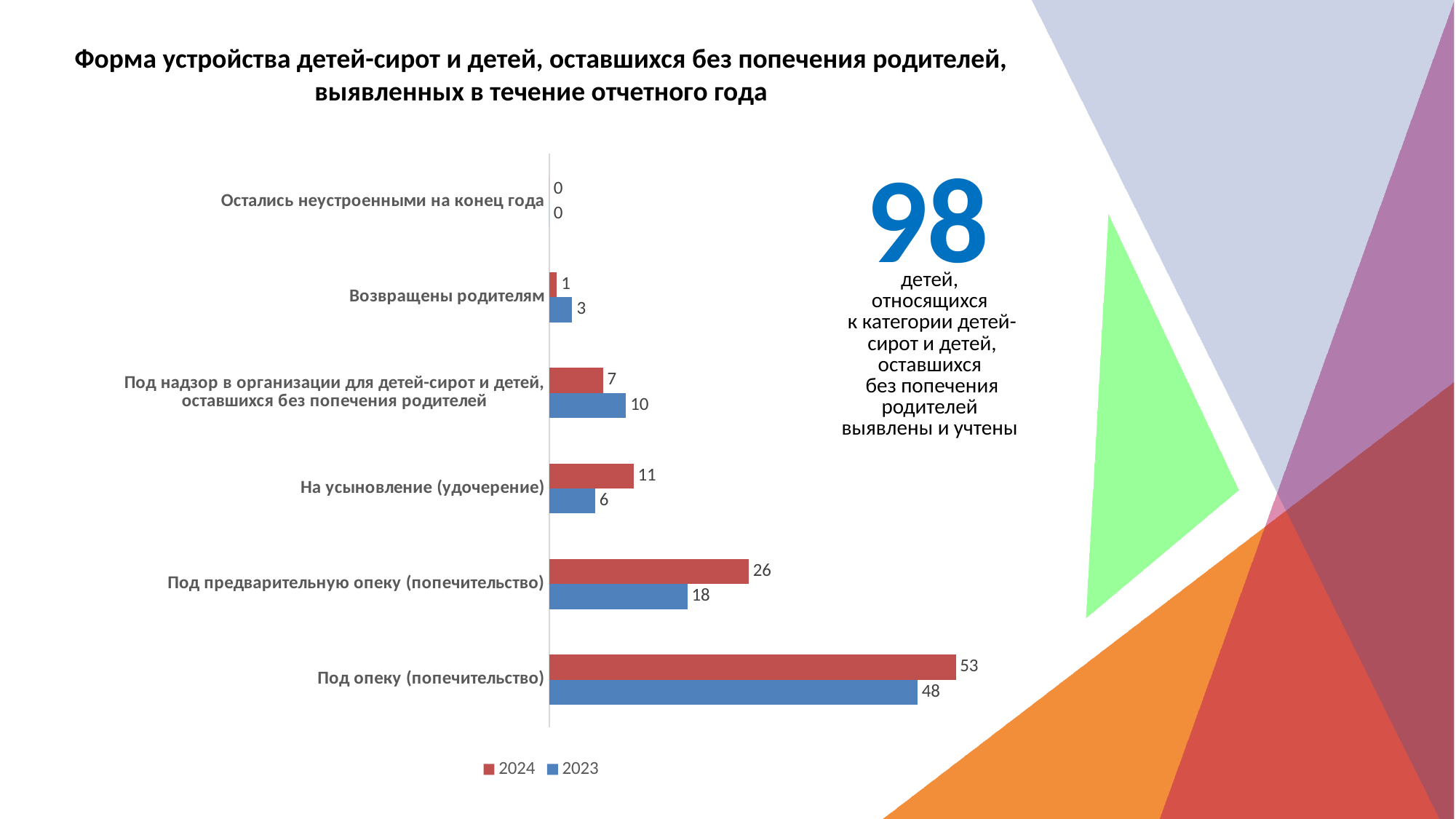
Which category has the lowest 2023 value? Остались неустроенными на конец года What is the 2023 value for «Возвращены родителям»? 3 What is the difference between the 2024 and 2023 values for «На усыновление (удочерение)»? 5 Which category has the highest 2024 value? Под опеку (попечительство) What kind of chart is shown on the slide? Bar chart What is the difference between the 2024 and 2023 values for «Под опеку (попечительство)»? 5 What is the 2024 value for «Под опеку (попечительство)»? 53 How many series does the legend list? 2 What is the 2024 value for «Под надзор в организации для детей-сирот и детей, оставшихся без попечения родителей»? 7 What is the 2023 value for «Под предварительную опеку (попечительство)»? 18 How many categories are shown on the chart? 6 For «Под предварительную опеку (попечительство)», which year has the larger value, 2024 or 2023? 2024